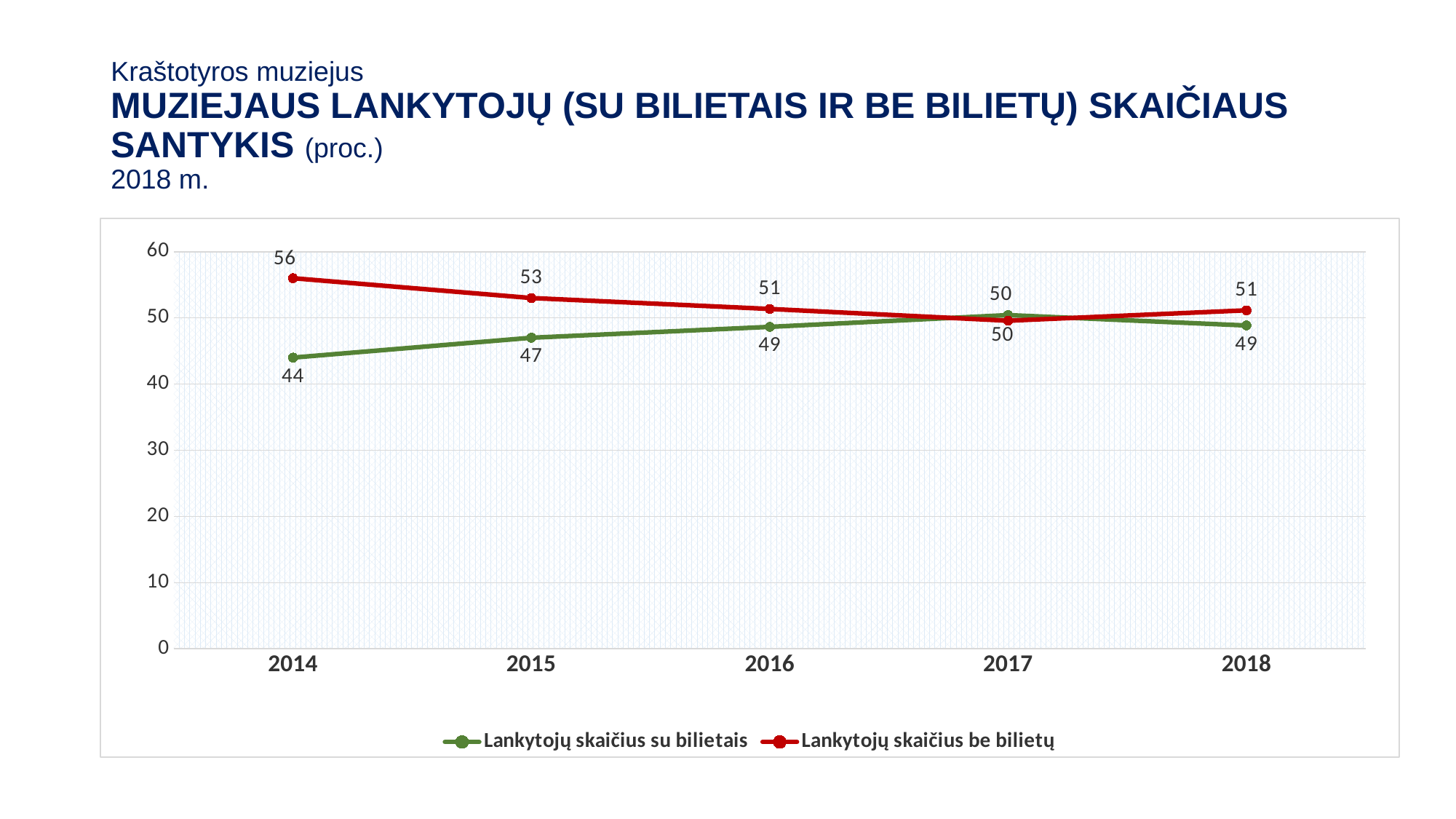
How many series does the legend list? 2 What is the value for Lankytojų skaičius be bilietų in 2014? 56 Does Lankytojų skaičius be bilietų rise or fall from 2014 to 2016? fall In which year is Lankytojų skaičius su bilietais lowest? 2014 Which series has the larger value in 2015, Lankytojų skaičius su bilietais or Lankytojų skaičius be bilietų? Lankytojų skaičius be bilietų What is the difference between Lankytojų skaičius be bilietų and Lankytojų skaičius su bilietais in 2014? 12 What is the value for Lankytojų skaičius su bilietais in 2014? 44 What kind of chart is shown on the slide? line chart How many years are shown on the x axis? 5 In which year is Lankytojų skaičius be bilietų highest? 2014 What is the value for Lankytojų skaičius be bilietų in 2018? 51 What is the value for Lankytojų skaičius su bilietais in 2016? 49